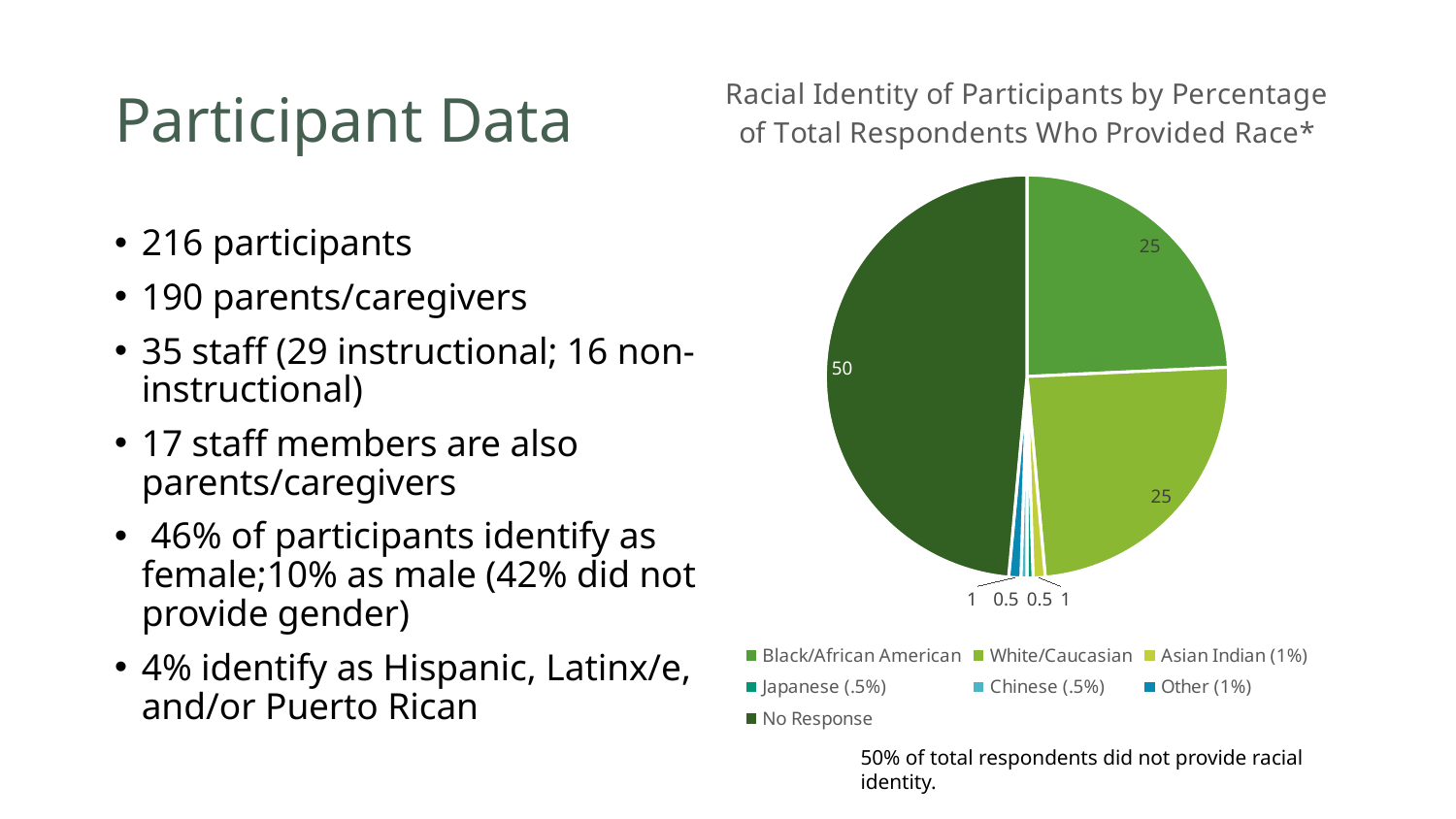
Which slice is larger in the pie chart, No Response or White/Caucasian? No Response Which category has the largest slice in the pie chart? No Response According to the legend, what percentage is given for Japanese? .5% What is the difference between the No Response value and the Black/African American value in the pie chart? 25 What is the title of the chart on the slide? Racial Identity of Participants by Percentage of Total Respondents Who Provided Race* What data label is shown on the White/Caucasian slice of the pie chart? 25 Which slice is larger in the pie chart, Asian Indian or Chinese? Asian Indian What data label is shown on the Black/African American slice of the pie chart? 25 What kind of chart is shown on the slide? Pie chart What data label is shown on the No Response slice of the pie chart? 50 According to the legend, what percentage is given for Other? 1% How many categories does the pie chart's legend list? 7